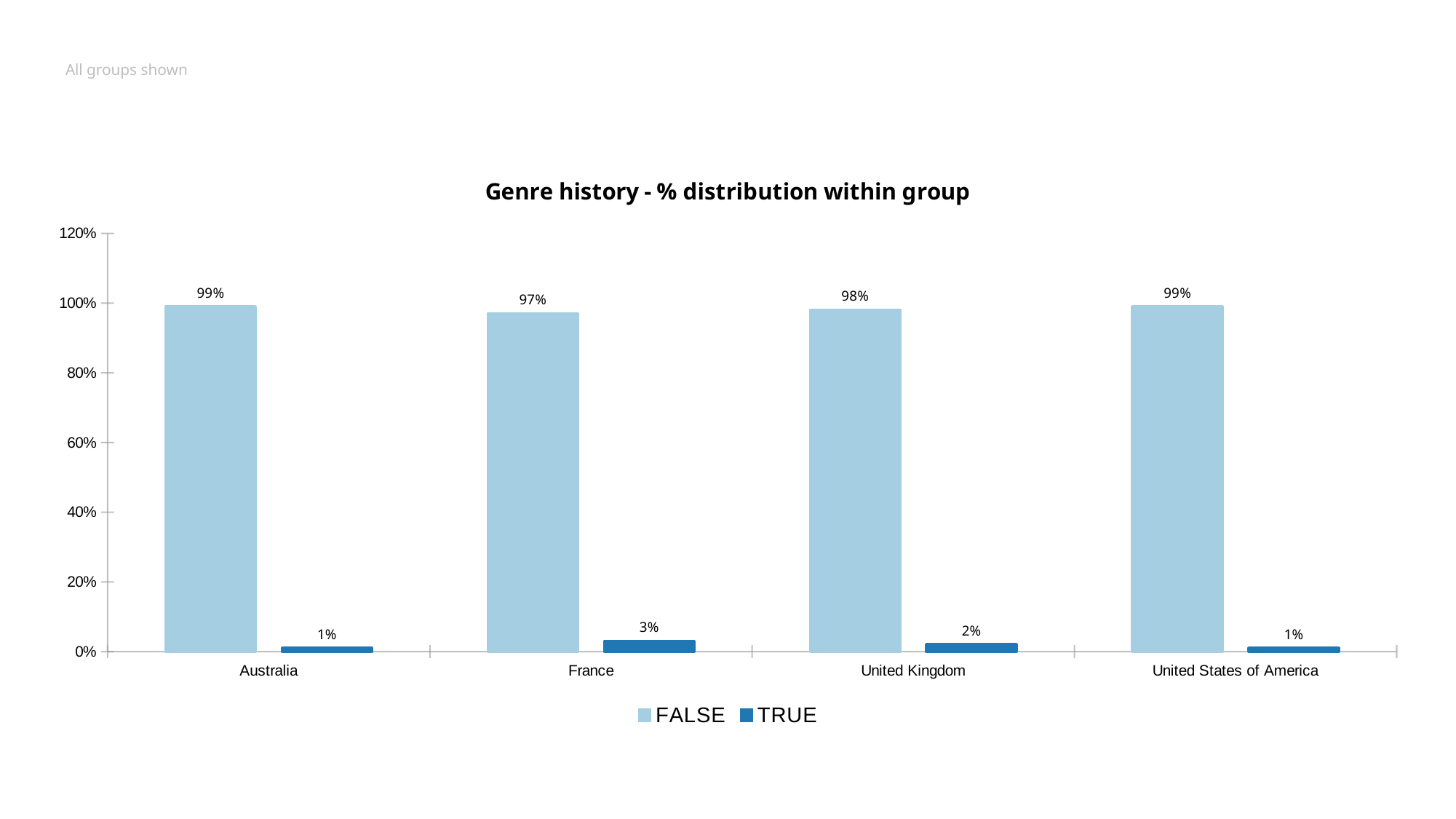
How many countries are shown on the x axis? 4 What is the FALSE value for the United States of America? 99% Which country has the lowest FALSE value? France What is the TRUE value for the United Kingdom? 2% How many series does the legend list? 2 Which is larger, the TRUE value for France or the TRUE value for Australia? France What is the TRUE value for France? 3% What is the FALSE value for France? 97% Is the FALSE value for France greater or less than 80%? greater What kind of chart is shown? Bar chart What is the difference between the FALSE and TRUE values for the United Kingdom? 96% Which country has the highest TRUE value? France